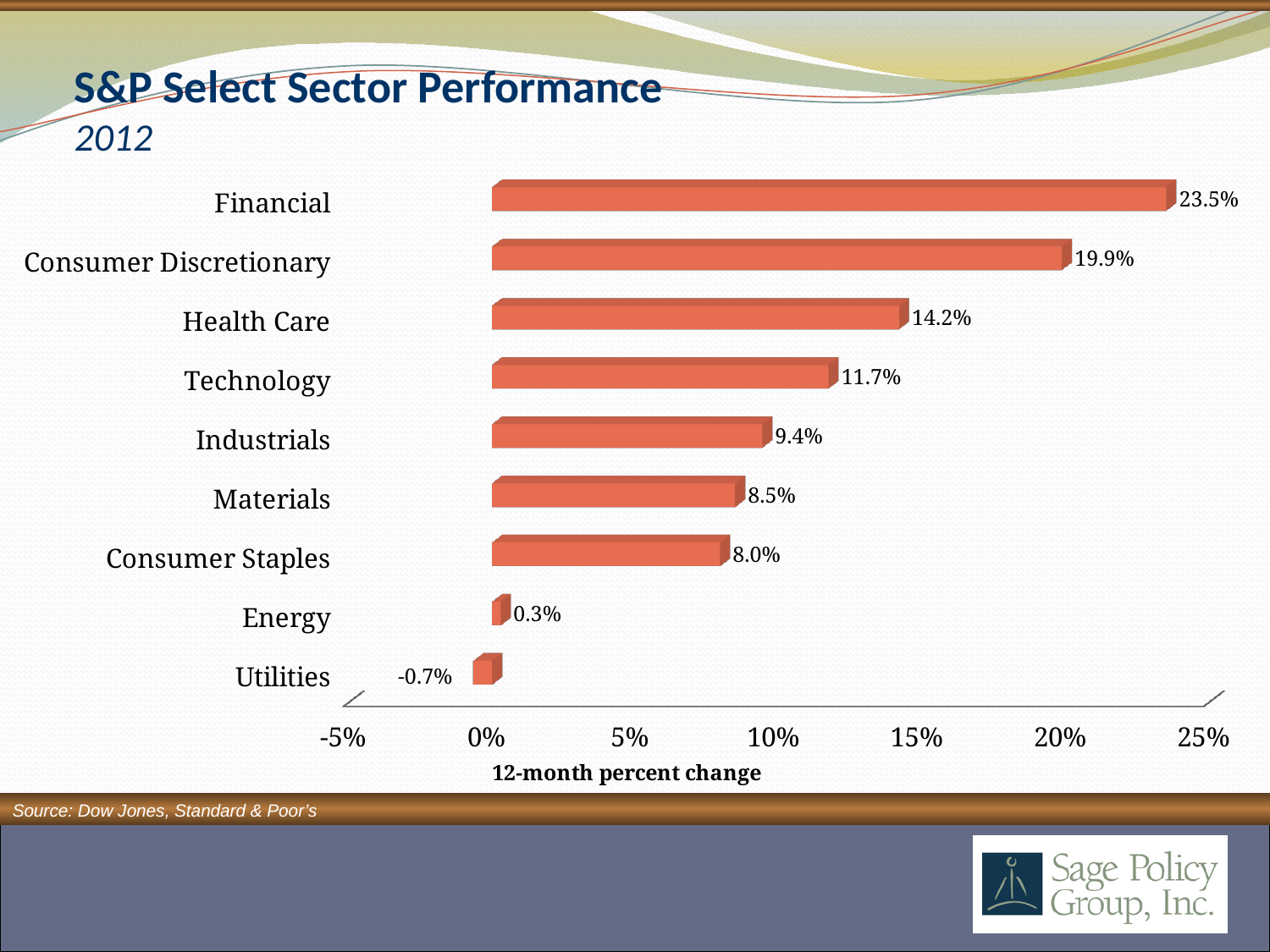
How many sectors are shown in the chart? 9 What is the 12-month percent change for Health Care? 14.2% What is the 12-month percent change for Utilities? -0.7% Is the value for Health Care greater or less than 10%? greater Which sector has the highest 12-month percent change? Financial What kind of chart is shown on the slide? Bar chart What is the 12-month percent change for Financial? 23.5% Which sector has the lowest 12-month percent change? Utilities What is the label on the horizontal axis of the chart? 12-month percent change What is the difference between the 12-month percent change for Technology and Industrials? 2.3% What is the difference between the 12-month percent change for Financial and Consumer Discretionary? 3.6% Which has a larger 12-month percent change, Materials or Consumer Staples? Materials